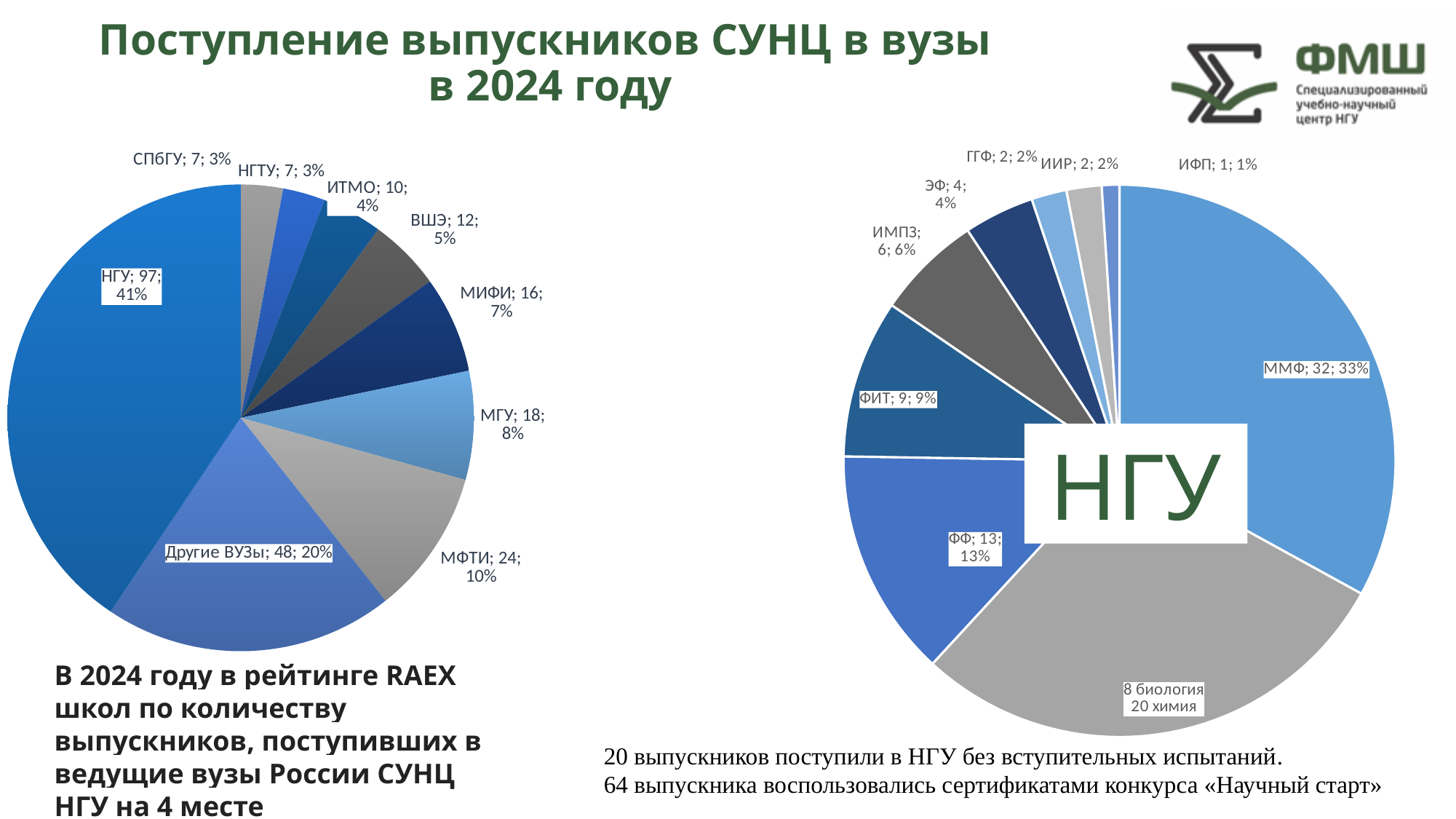
On the right pie chart, how many graduates entered ММФ? 32 On the right pie chart, what share does ФФ have? 13% On the right pie chart, what is the difference between the values for ФИТ and ИМПЗ? 3 On the left pie chart, what is the difference between the number of graduates who entered МГУ and МИФИ? 2 On the left pie chart, how many graduates are in the category Другие ВУЗы? 48 What type of chart is shown on the left of the slide? Pie chart On the left pie chart, which university has the largest slice? НГУ On the right pie chart, which faculty has the smallest slice? ИФП On the left pie chart, which is larger: the value for ВШЭ or the value for ИТМО? ВШЭ On the left pie chart, what share of graduates entered МФТИ? 10% On the left pie chart, how many graduates entered НГУ? 97 On the right pie chart, which is larger: the value for ЭФ or the value for ГГФ? ЭФ